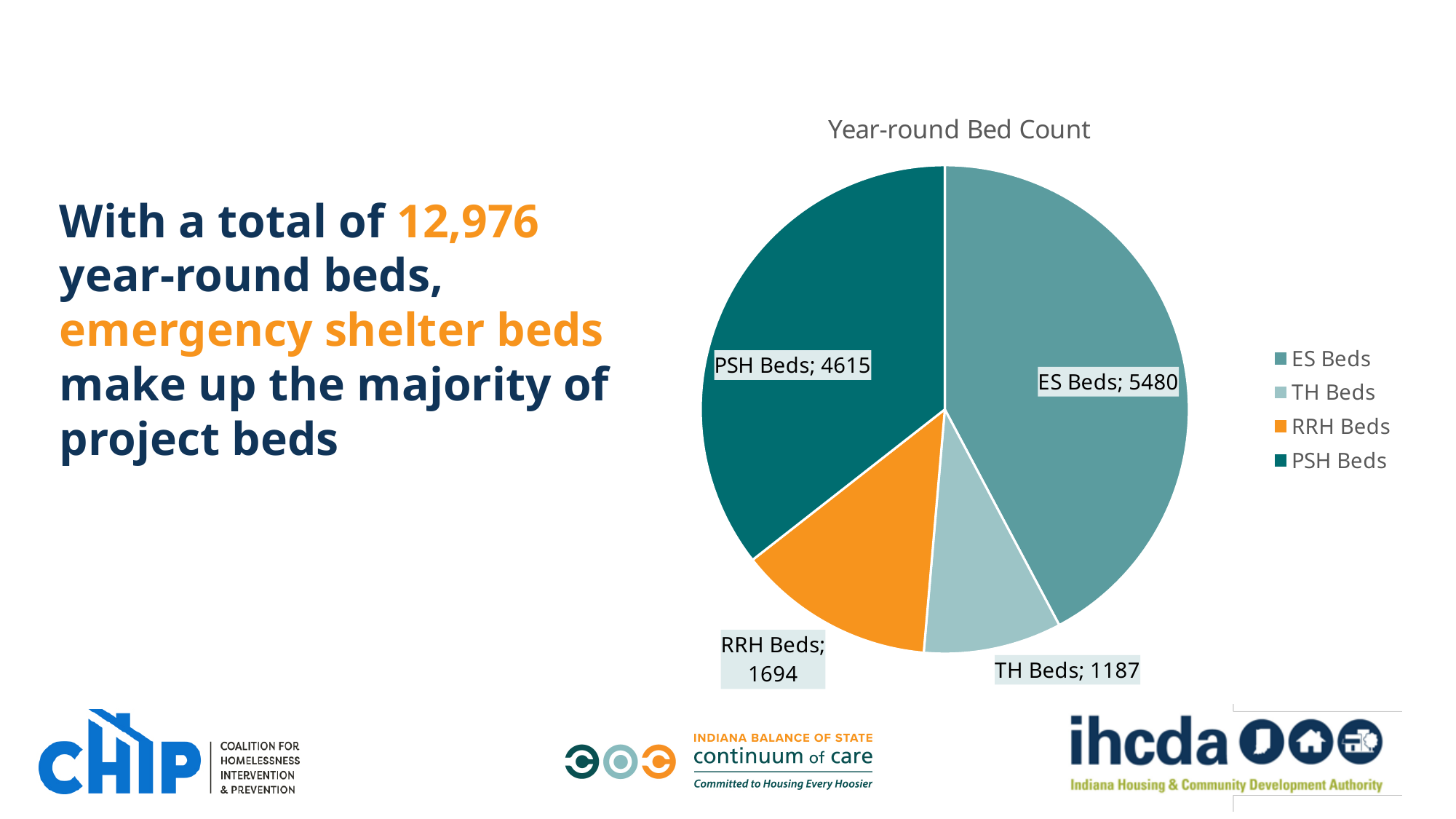
How many entries does the legend list? 4 What is the title of the chart? Year-round Bed Count Which category has the smallest slice? TH Beds What kind of chart is shown on the slide? pie chart What is the value for RRH Beds? 1694 Which category has the largest slice? ES Beds What is the value for ES Beds? 5480 Which is larger, RRH Beds or TH Beds? RRH Beds What is the value for PSH Beds? 4615 How many slices does the pie chart have? 4 What is the difference between ES Beds and PSH Beds? 865 What is the value for TH Beds? 1187